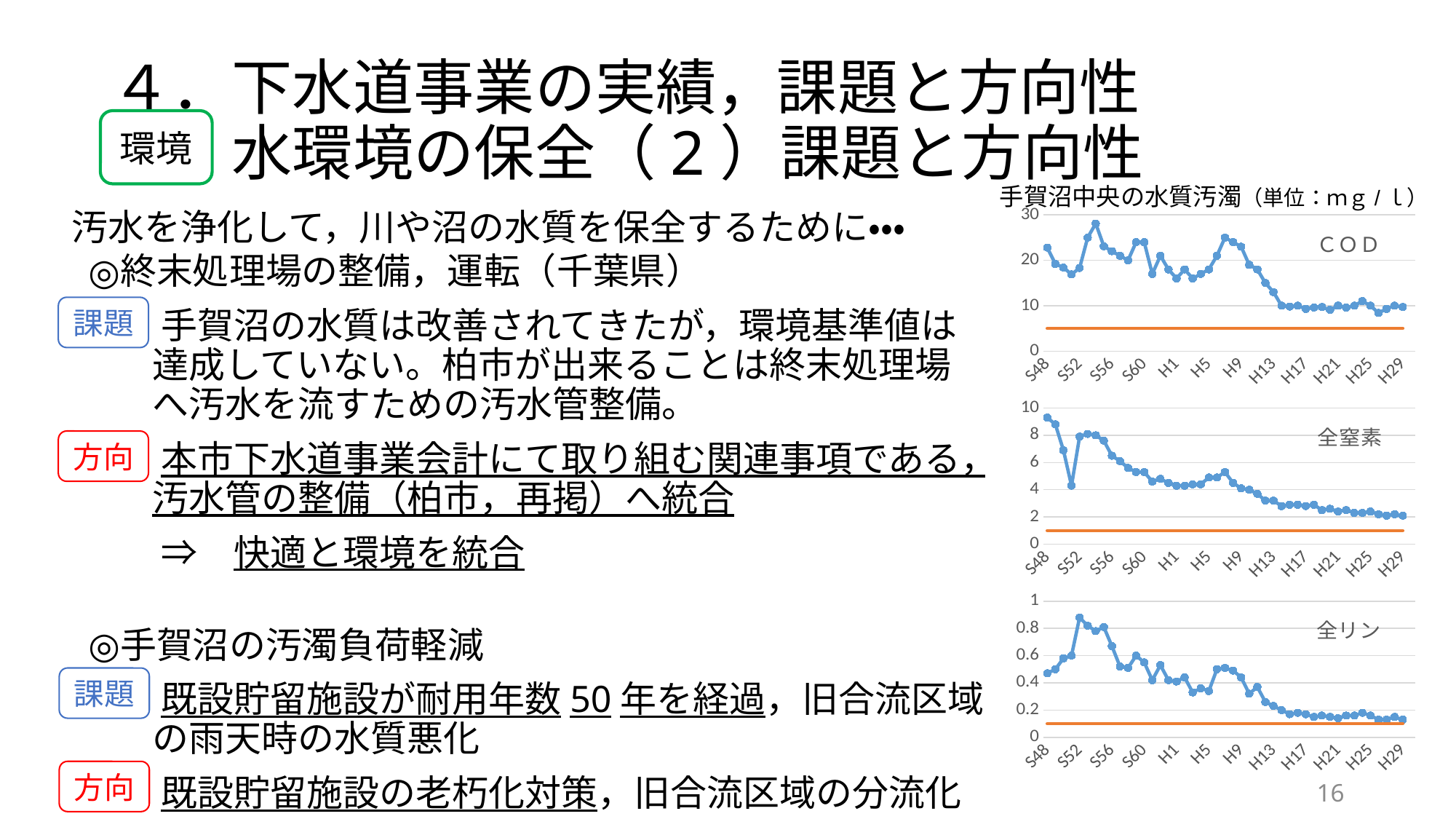
In the 全リン chart, is the value at H29 greater or less than 0.4? less In the 全窒素 chart, is the value at H29 greater or less than 4? less In the 全窒素 chart, do the values generally rise or fall from S48 to H29? fall How many charts are shown on the right side of the slide? 3 In the ＣＯＤ chart, is the value at H29 greater or less than 20? less In the ＣＯＤ chart, do the values generally rise or fall from S48 to H29? fall What kind of chart is the ＣＯＤ chart on the right of the slide? line chart In the 全リン chart, do the values generally rise or fall from S48 to H29? fall What is the title shown above the three charts on the right? 手賀沼中央の水質汚濁（単位：ｍｇ/ｌ） What unit is given in the title of the charts on the right? ｍｇ/ｌ